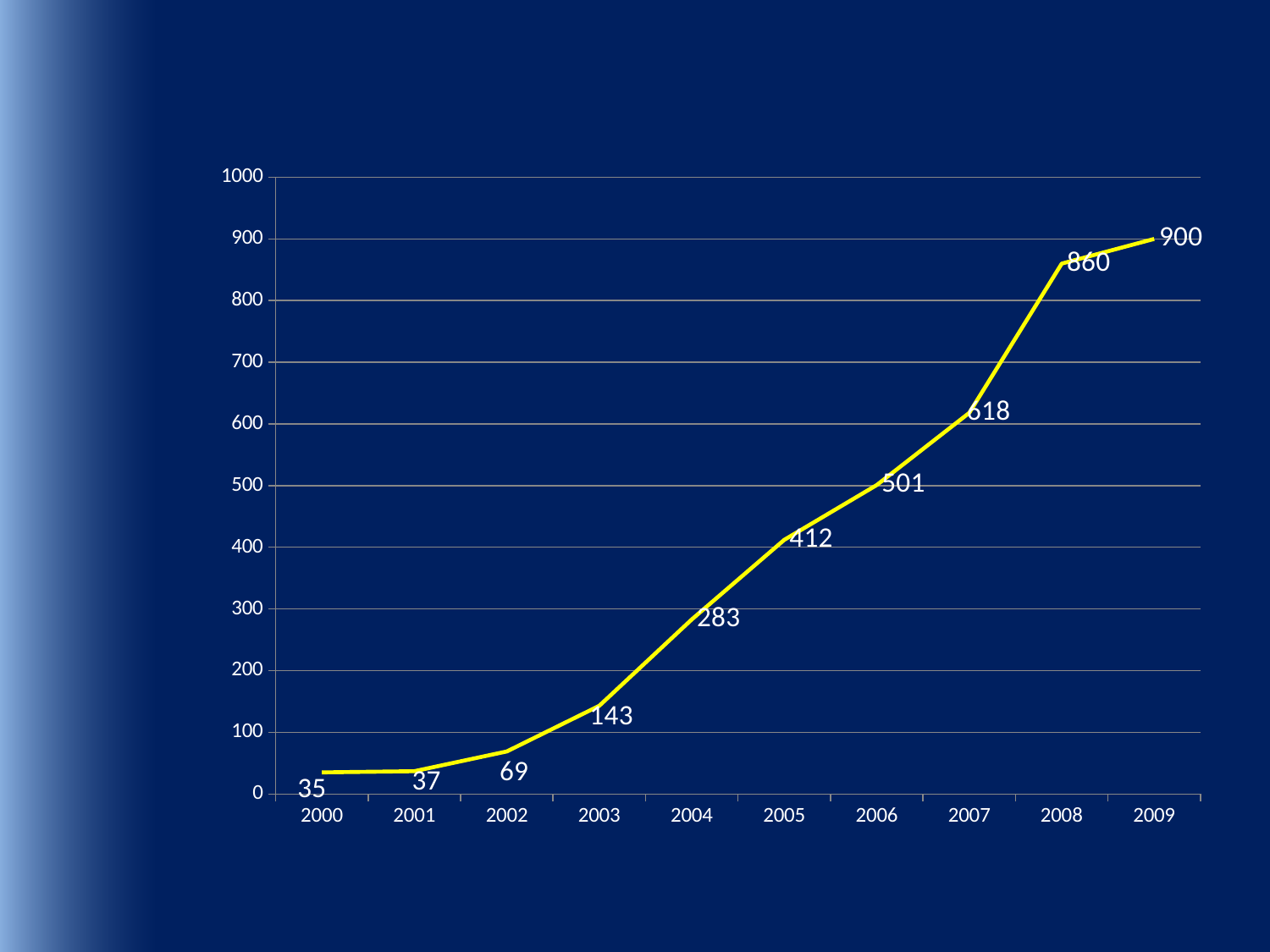
What kind of chart is shown on the slide? line chart What is the value for 2000? 35 Which is larger, the value for 2005 or the value for 2006? 2006 What is the value for 2004? 283 What is the value for 2007? 618 What is the difference between the values for 2008 and 2007? 242 How many years are plotted on the x axis? 10 Is the value for 2003 greater or less than 100? greater What is the difference between the values for 2009 and 2000? 865 Do the values rise or fall from 2000 to 2009? rise Which year has the highest value? 2009 Which year has the lowest value? 2000